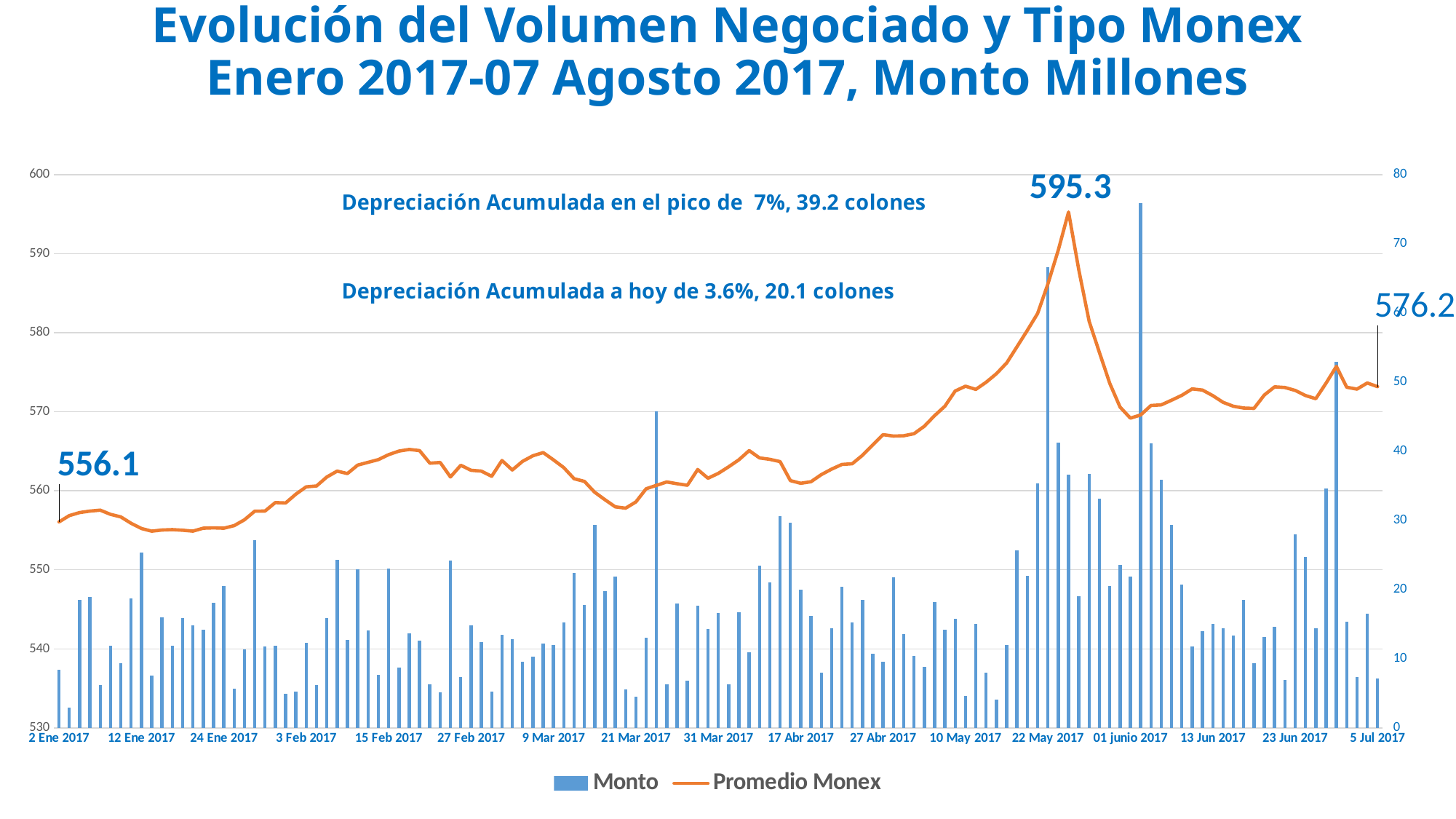
What is the difference between the labelled peak value (595.3) and the labelled starting value (556.1) of Promedio Monex? 39.2 What kind of chart is shown on the slide? Combined bar and line chart Which is larger: the labelled Promedio Monex value at the start (556.1) or at the end (576.2)? 576.2 (end) Does the Promedio Monex line rise or fall between 10 May 2017 and its peak near 22 May 2017? rise What is the difference between the labelled end value (576.2) and the labelled starting value (556.1) of Promedio Monex? 20.1 What value is labelled for Promedio Monex at the start of the series (2 Ene 2017)? 556.1 What are the two legend entries of the chart? Monto and Promedio Monex What value is labelled for Promedio Monex at the end of the series? 576.2 What is the peak value labelled on the Promedio Monex line? 595.3 How many series does the legend list? 2 Is the tallest Monto bar, near 01 junio 2017, greater or less than 70 on the right-hand axis? greater Is the Promedio Monex value at 2 Ene 2017 greater or less than 560? less